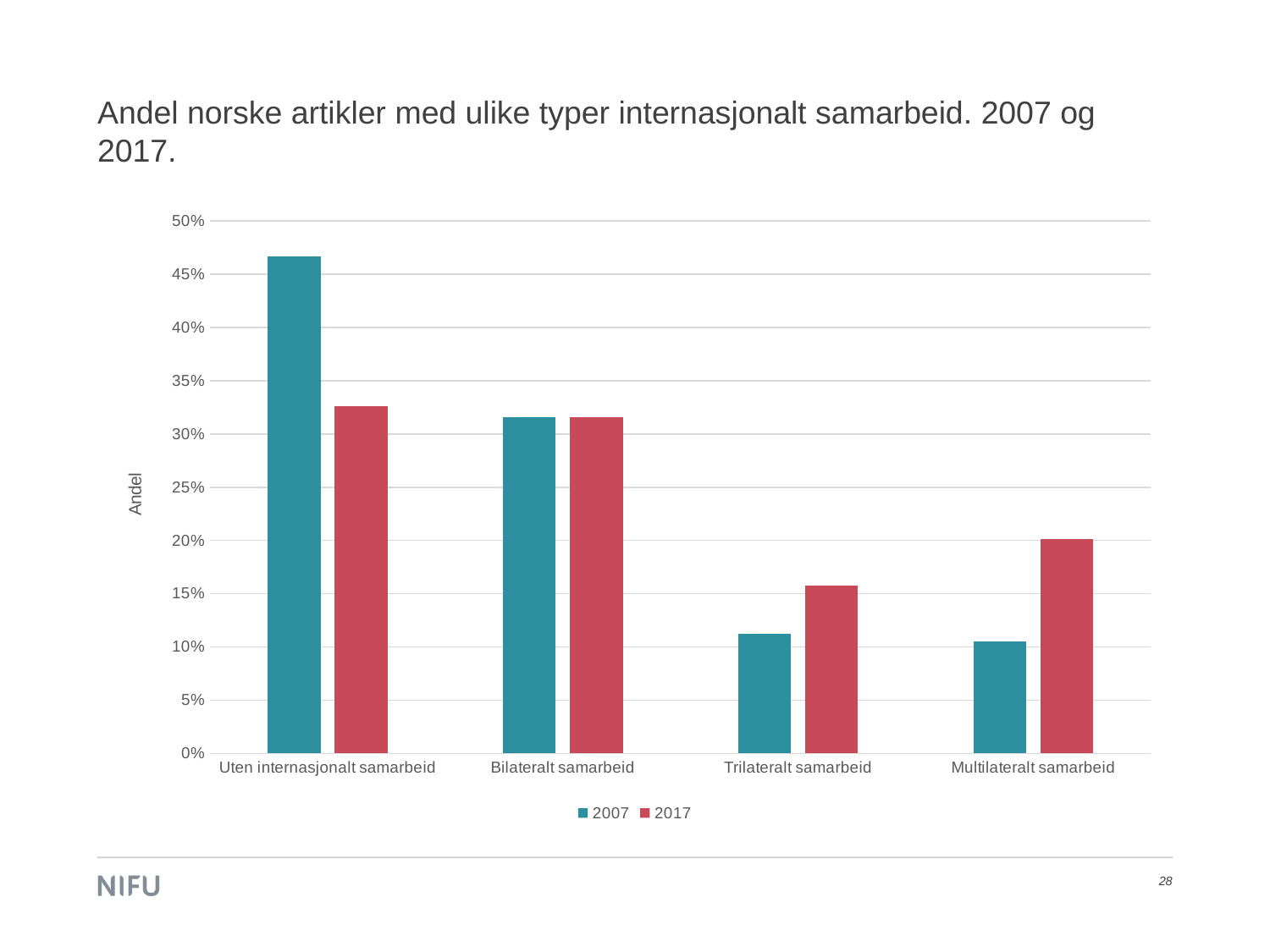
Which category has the highest value for 2007? Uten internasjonalt samarbeid How many categories are shown on the x axis? 4 Which category has the lowest value for 2017? Trilateralt samarbeid For Multilateralt samarbeid, which year has the larger value, 2007 or 2017? 2017 Is the 2017 value for Multilateralt samarbeid greater or less than 15%? greater What kind of chart is shown on the slide? bar chart For Uten internasjonalt samarbeid, which year has the larger value, 2007 or 2017? 2007 Is the 2007 value for Multilateralt samarbeid greater or less than 15%? less Is the 2017 value for Uten internasjonalt samarbeid greater or less than 35%? less Do the 2007 values rise or fall moving from left to right along the x axis? fall How many series does the legend list? 2